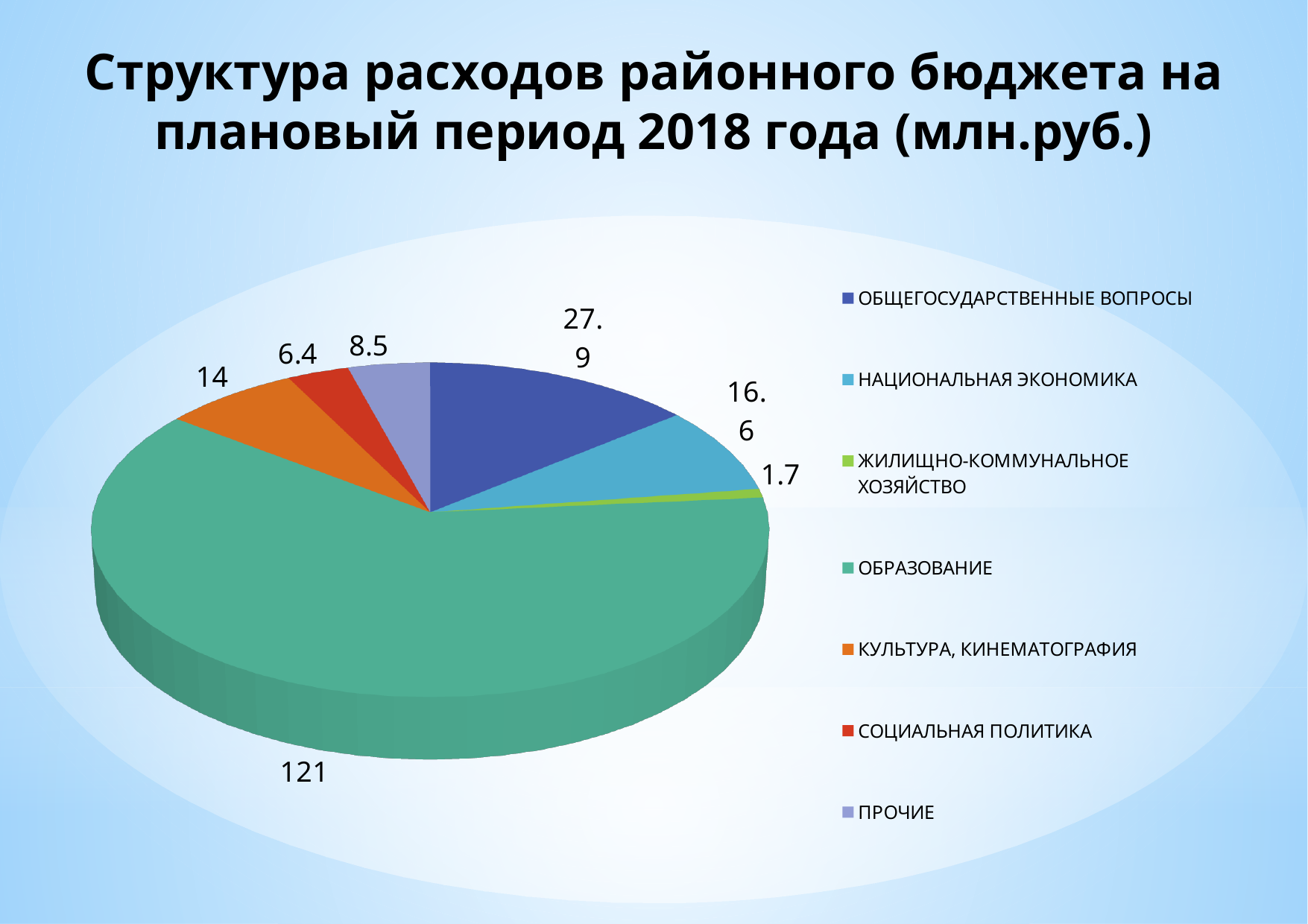
What is the value for ОБРАЗОВАНИЕ? 121 Which is larger, the value for КУЛЬТУРА, КИНЕМАТОГРАФИЯ or the value for ПРОЧИЕ? КУЛЬТУРА, КИНЕМАТОГРАФИЯ What is the title of the chart on the slide? Структура расходов районного бюджета на плановый период 2018 года (млн.руб.) What is the value for СОЦИАЛЬНАЯ ПОЛИТИКА? 6.4 What is the value for ЖИЛИЩНО-КОММУНАЛЬНОЕ ХОЗЯЙСТВО? 1.7 How many categories does the legend list? 7 What is the value for ОБЩЕГОСУДАРСТВЕННЫЕ ВОПРОСЫ? 27.9 Which category has the smallest slice of the pie? ЖИЛИЩНО-КОММУНАЛЬНОЕ ХОЗЯЙСТВО What is the difference between the values for ОБЩЕГОСУДАРСТВЕННЫЕ ВОПРОСЫ and НАЦИОНАЛЬНАЯ ЭКОНОМИКА? 11.3 What is the value for НАЦИОНАЛЬНАЯ ЭКОНОМИКА? 16.6 What type of chart is shown on the slide? Pie chart Which category has the largest slice of the pie? ОБРАЗОВАНИЕ